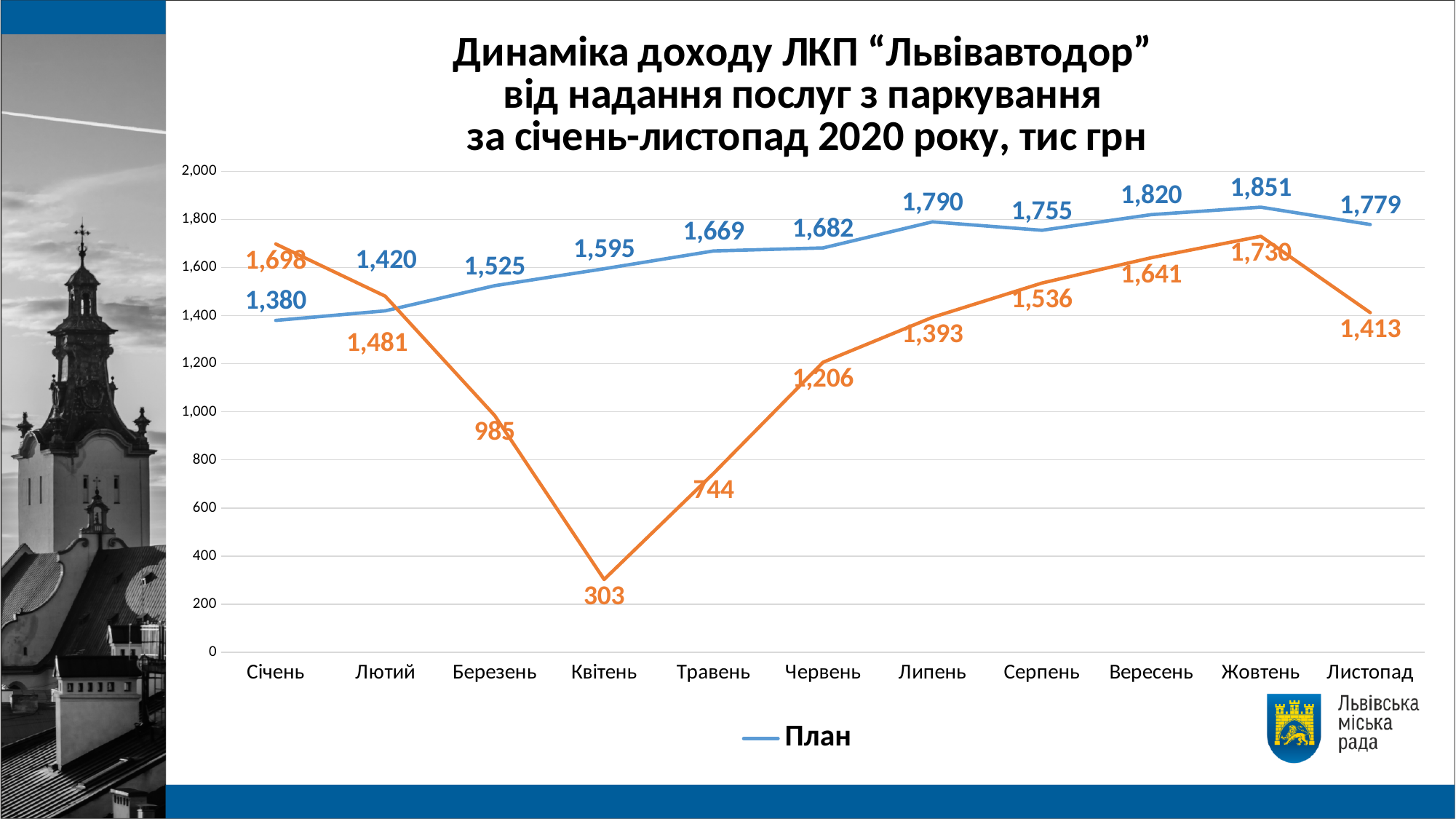
How many months are shown on the x axis? 11 What is the value of the orange line for Листопад? 1,413 Does the План series rise or fall from Січень to Липень? rise What is the difference between the План value and the orange line value in Квітень? 1,292 What is the difference between the План value and the orange line value in Жовтень? 121 What is the value of the orange line for Квітень? 303 In which month does the План series reach its highest value? Жовтень What kind of chart is shown on the slide? line chart In Січень, which is larger: the План value or the orange line value? the orange line value Is the value of the orange line for Травень greater or less than 800? less In which month does the orange line reach its lowest value? Квітень What is the value of the План series for Квітень? 1,595